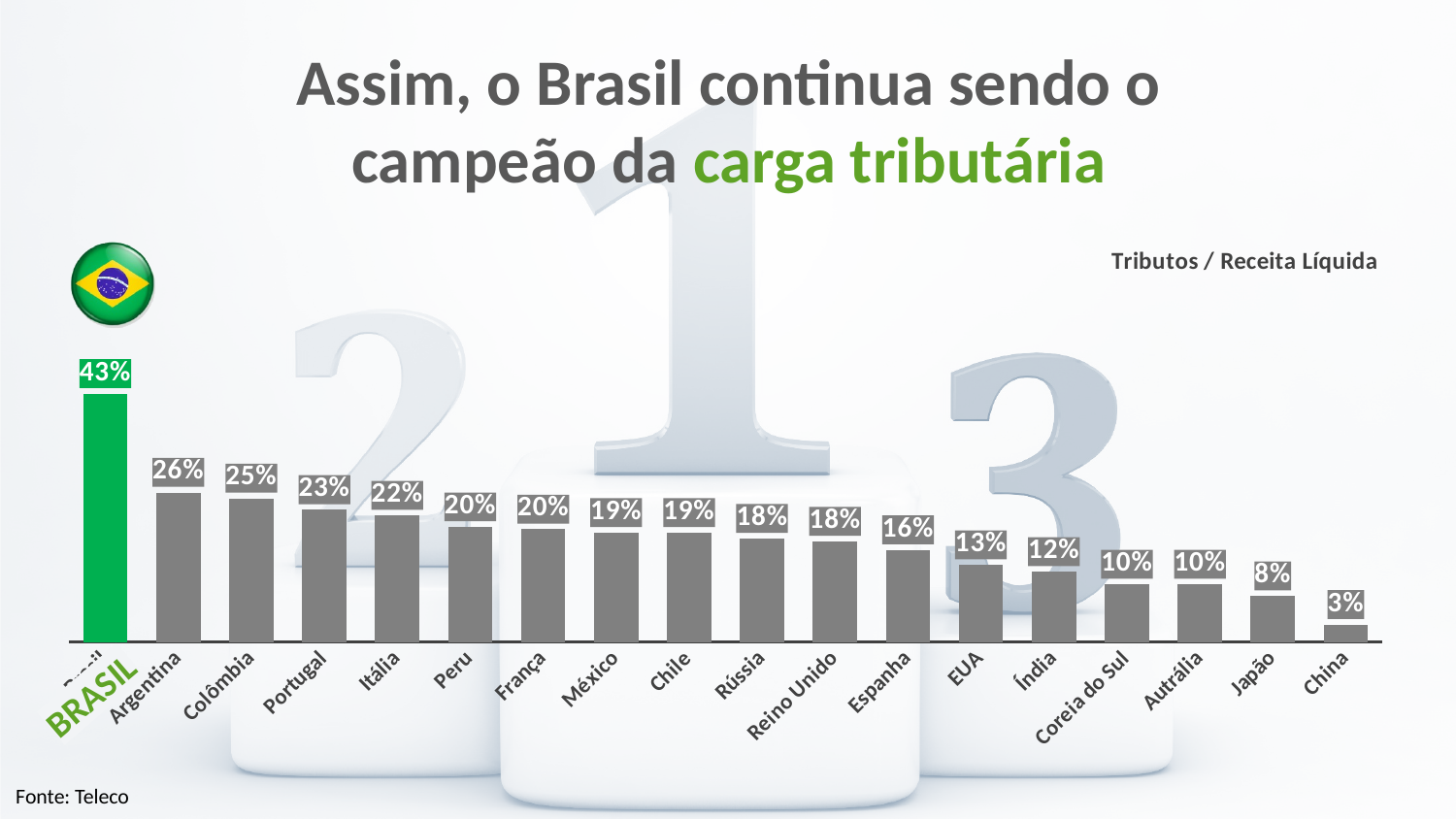
What is the value for EUA? 13% What label appears in the top right of the chart describing the measure? Tributos / Receita Líquida Which country has the lowest value? China Which is larger, the value for Colômbia or the value for Espanha? Colômbia What is the value for Brasil? 43% How many countries are shown in the chart? 18 What is the difference between the values for Brasil and Argentina? 17% What is the value for Argentina? 26% What kind of chart is shown on the slide? Bar chart What is the value for Japão? 8% What is the difference between the values for Portugal and Índia? 11% Which country has the highest value? Brasil